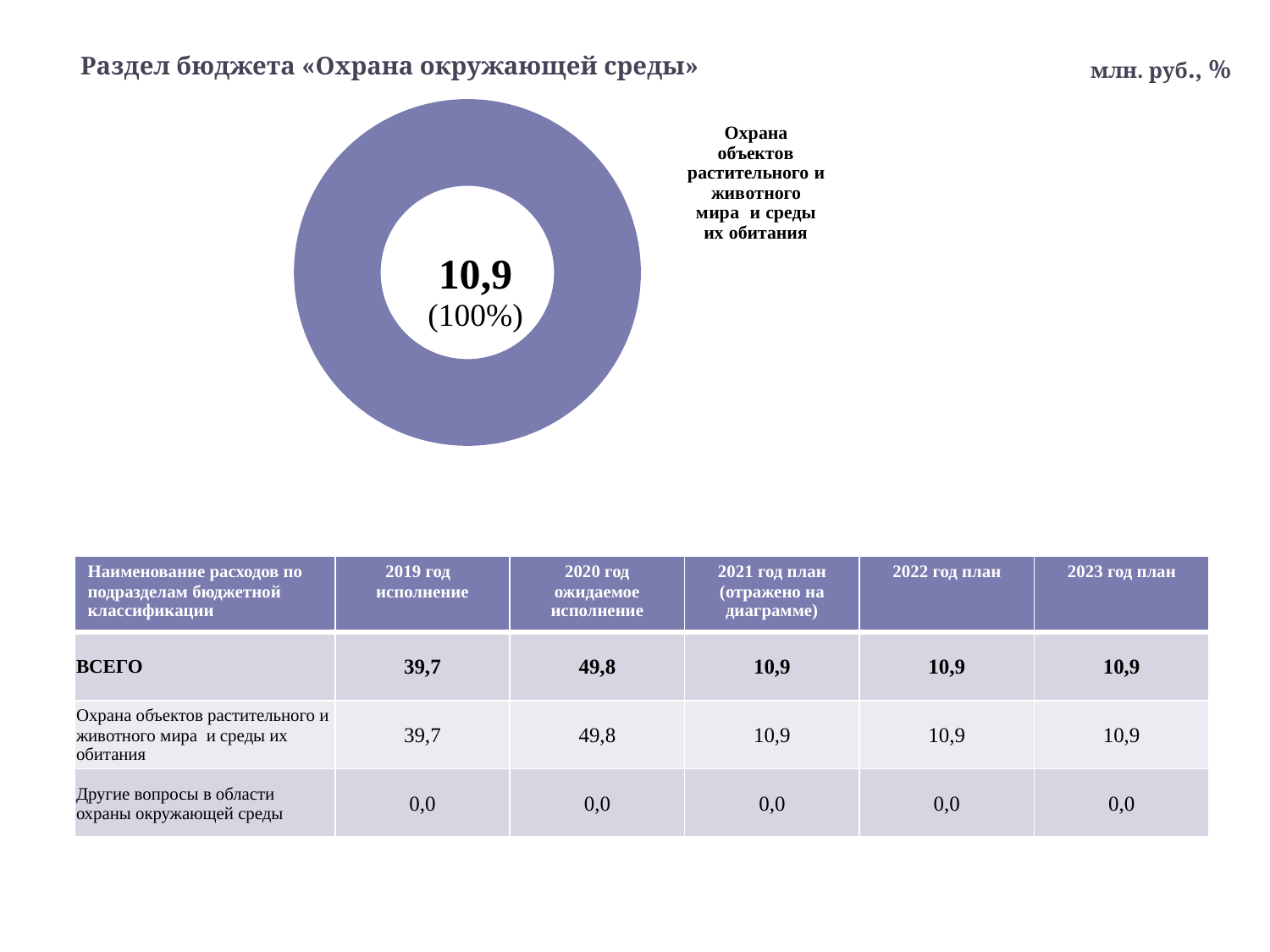
What value is printed in the centre of the donut chart? 10,9 What is the title of the slide containing the donut chart? Раздел бюджета «Охрана окружающей среды» Which category is shown as the only slice of the donut chart? Охрана объектов растительного и животного мира и среды их обитания What is the value for «Охрана объектов растительного и животного мира и среды их обитания» shown in the donut chart? 10,9 How many slices does the donut chart contain? 1 Is the value shown in the centre of the donut chart greater or less than 10? greater What share of the donut chart does the slice «Охрана объектов растительного и животного мира и среды их обитания» represent? 100% What kind of chart is shown on the slide? Donut (pie) chart